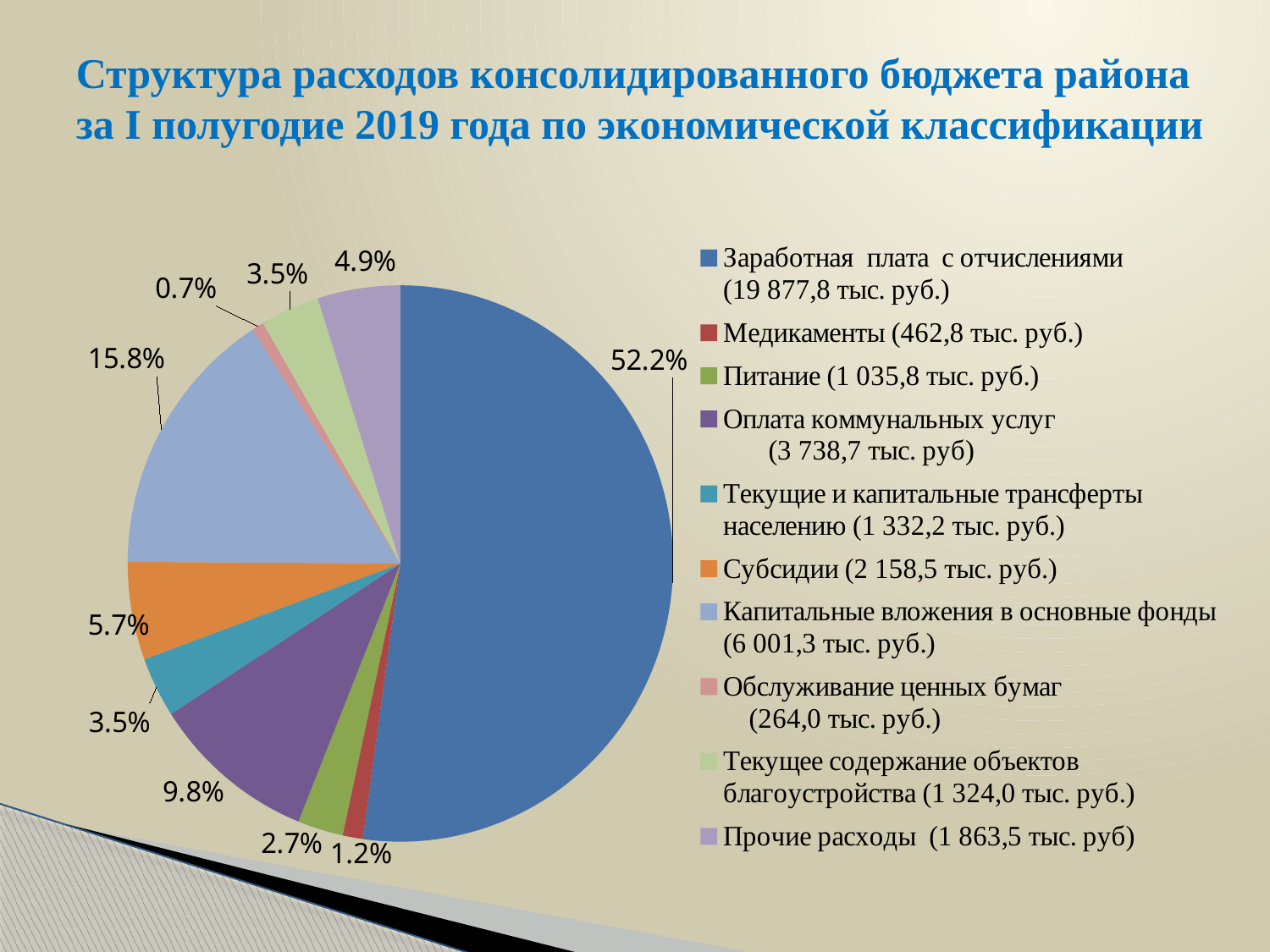
What share of the pie does "Медикаменты" take? 1.2% Which category has the smallest slice of the pie? Обслуживание ценных бумаг What is the difference in percentage points between the "Капитальные вложения в основные фонды" slice and the "Субсидии" slice? 10.1 What share of the pie does "Заработная плата с отчислениями" take? 52.2% According to the legend, what amount is given for "Субсидии"? 2 158,5 тыс. руб. What share of the pie does "Оплата коммунальных услуг" take? 9.8% According to the legend, what amount is given for "Заработная плата с отчислениями"? 19 877,8 тыс. руб. How many slices does the pie chart have? 10 Which slice is larger: "Прочие расходы" or "Питание"? Прочие расходы Which category has the largest slice of the pie? Заработная плата с отчислениями What kind of chart is shown on the slide? Pie chart